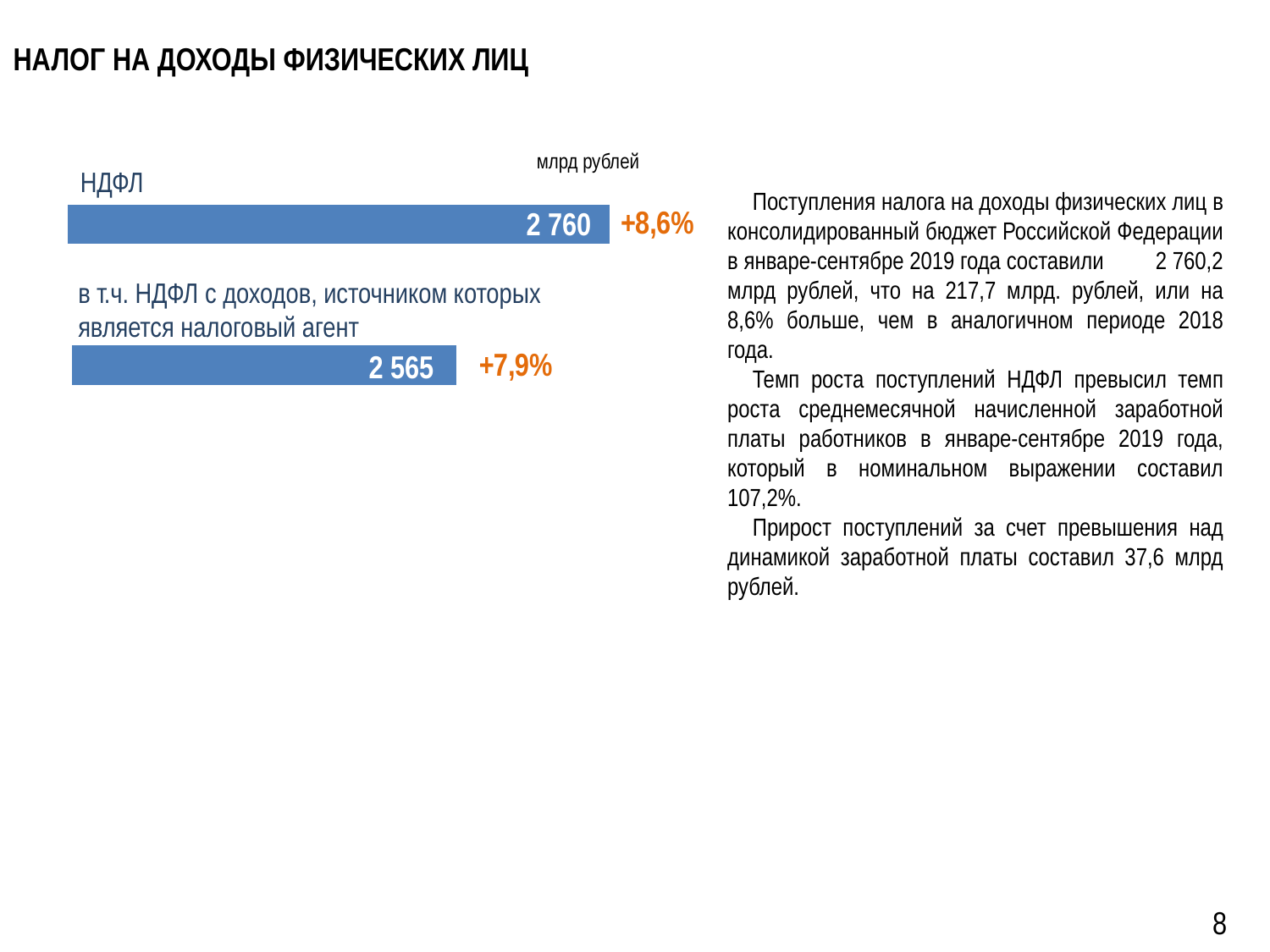
What is the difference between the НДФЛ value and the value for НДФЛ с доходов, источником которых является налоговый агент? 195 Which bar has the lowest value on the chart? в т.ч. НДФЛ с доходов, источником которых является налоговый агент What colour are the bars on the chart? Blue Which bar shows the larger growth percentage? НДФЛ What growth percentage is shown next to the bar for НДФЛ с доходов, источником которых является налоговый агент? +7,9% What growth percentage is shown next to the НДФЛ bar? +8,6% In what units are the chart values given? млрд рублей What is the value shown for the НДФЛ bar? 2 760 What kind of chart is shown on the slide? Bar chart What is the value shown for the bar labelled «в т.ч. НДФЛ с доходов, источником которых является налоговый агент»? 2 565 How many bars are plotted on the chart? 2 Which bar has the higher value, НДФЛ or НДФЛ с доходов, источником которых является налоговый агент? НДФЛ